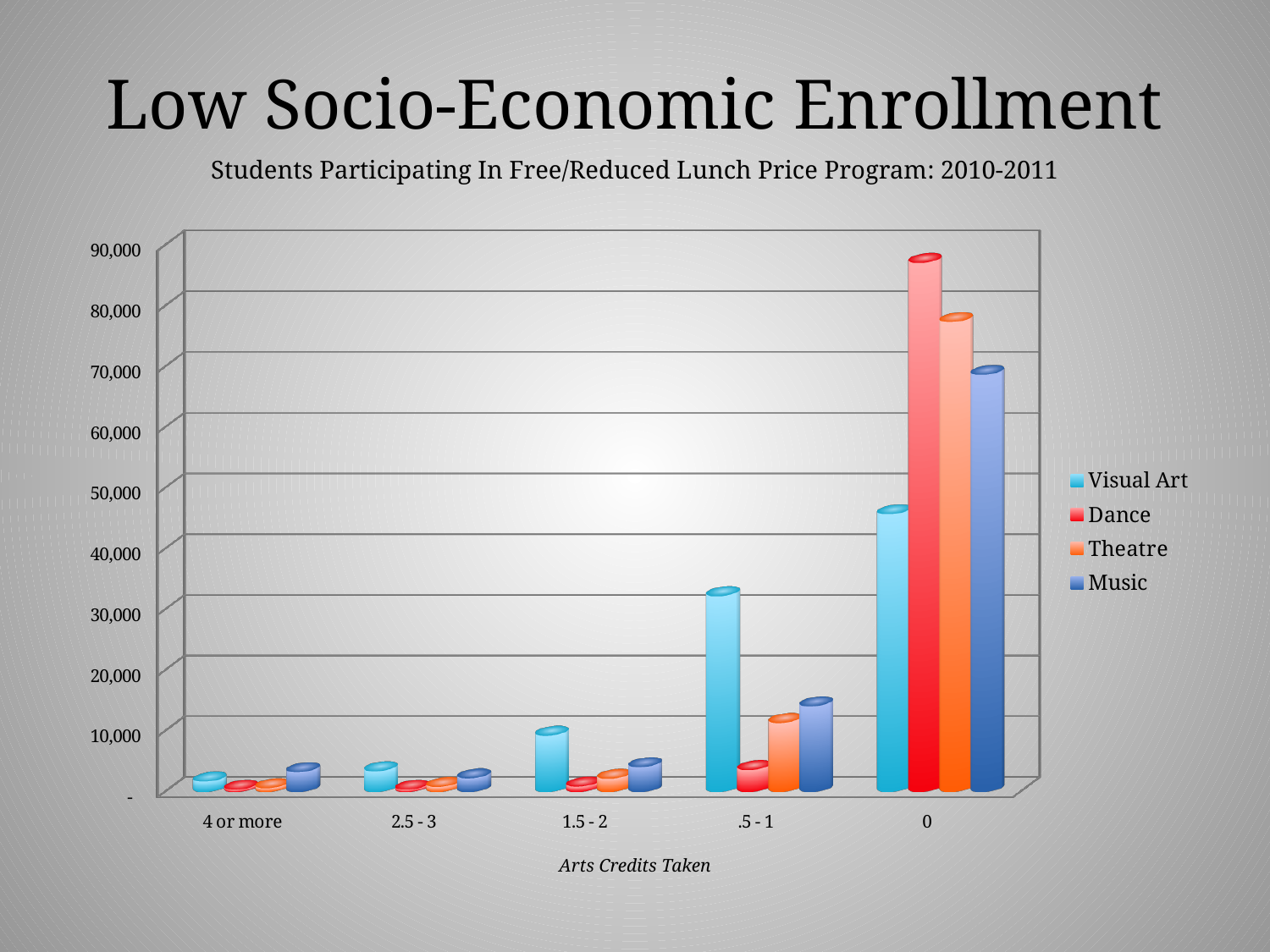
How many categories are shown along the x axis of the chart? 5 What is the label of the chart's x axis? Arts Credits Taken Moving from '4 or more' to '0' along the x axis, do the Visual Art values rise or fall? Rise Which arts-credit category has the highest Visual Art value? 0 In the 0 credits category, which series has the tallest bar? Dance What kind of chart is shown on the slide? Bar chart In the .5 - 1 credits category, which is larger, Visual Art or Dance? Visual Art Is the Dance value for the 0 credits category greater or less than 80,000? greater How many series does the chart's legend list? 4 Is the Visual Art value for the .5 - 1 credits category greater or less than 40,000? less In the 0 credits category, which series has the shortest bar? Visual Art Which arts-credit category has the highest Dance value? 0